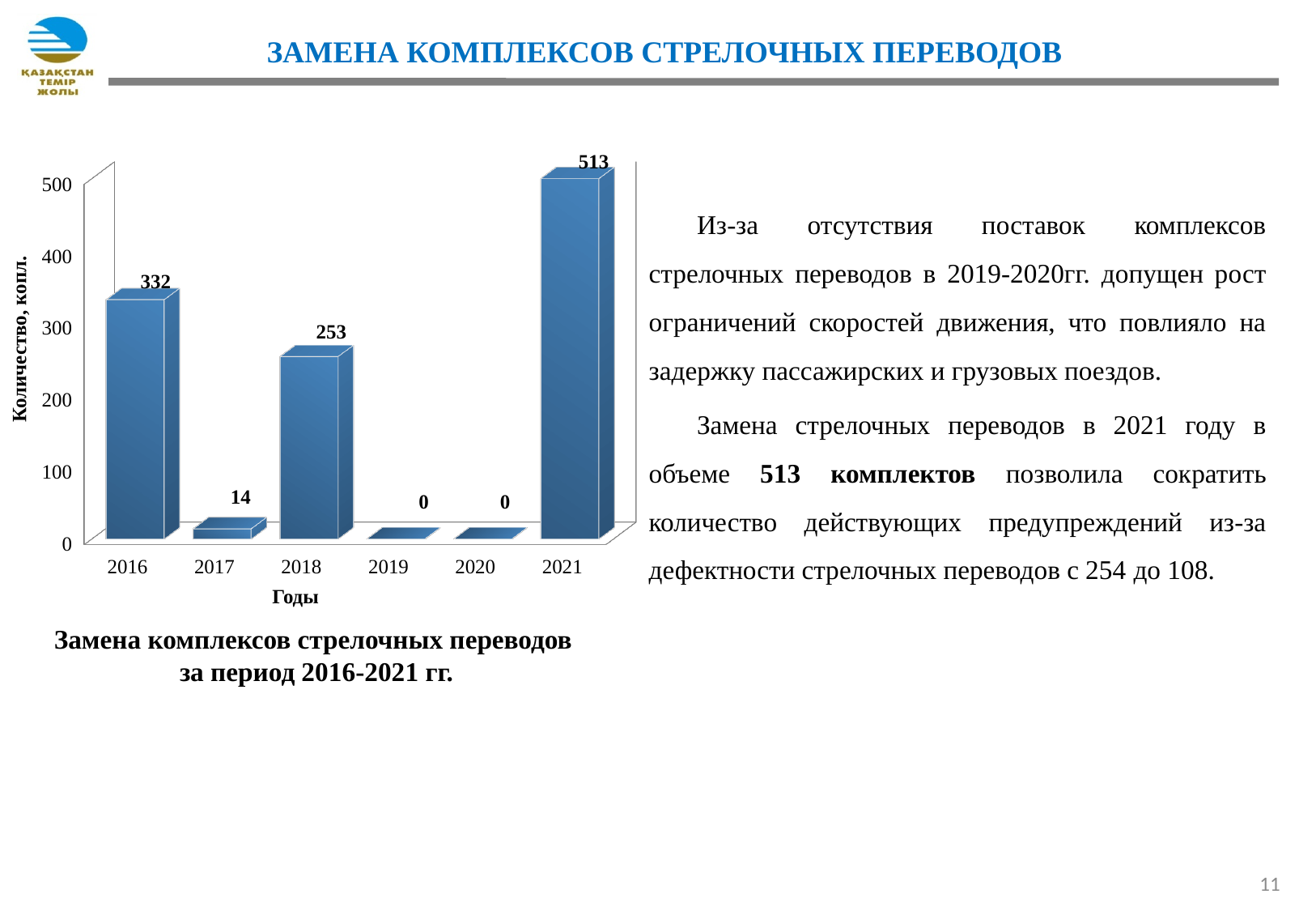
What kind of chart is shown on the slide? Bar chart What is the difference between the values for 2016 and 2018? 79 What is the value for 2016? 332 What is the value for 2017? 14 What is the difference between the values for 2021 and 2016? 181 Which is larger, the value for 2018 or the value for 2017? 2018 What is the value for 2021? 513 Which years have a value of 0? 2019 and 2020 What is the label of the vertical axis? Количество, компл. What is the value for 2018? 253 How many years are shown on the x axis? 6 Which year has the highest value? 2021